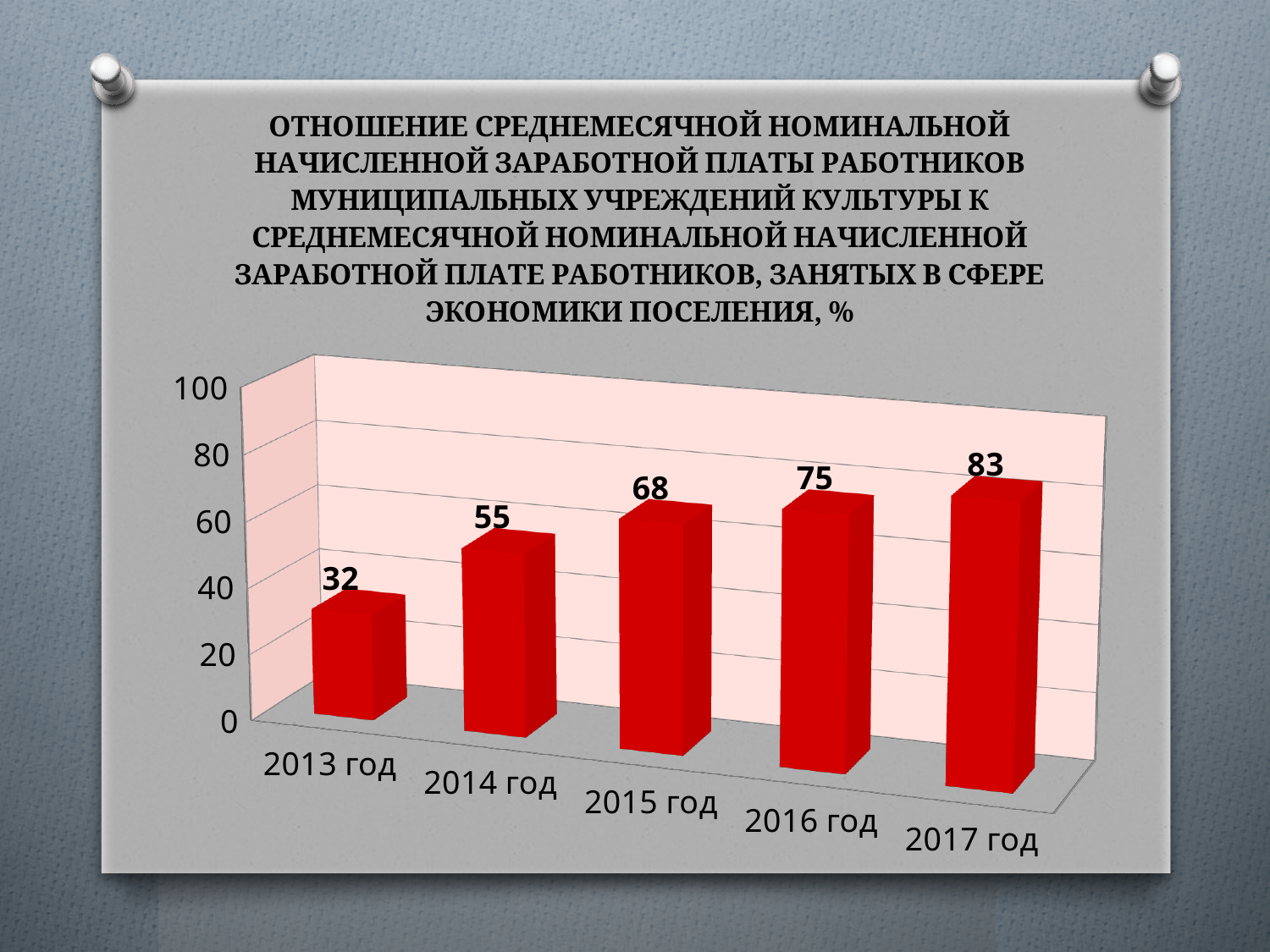
What is the value for 2015 год? 68 How many years are shown on the chart? 5 What is the value for 2013 год? 32 Is the value for 2015 год greater or less than 60? greater What is the difference between the values for 2017 год and 2013 год? 51 Do the values rise or fall from 2013 год to 2017 год? rise What is the difference between the values for 2016 год and 2014 год? 20 What is the value for 2017 год? 83 What kind of chart is shown on the slide? bar chart Which year has the highest value? 2017 год Which is larger, the value for 2014 год or the value for 2016 год? 2016 год Which year has the lowest value? 2013 год